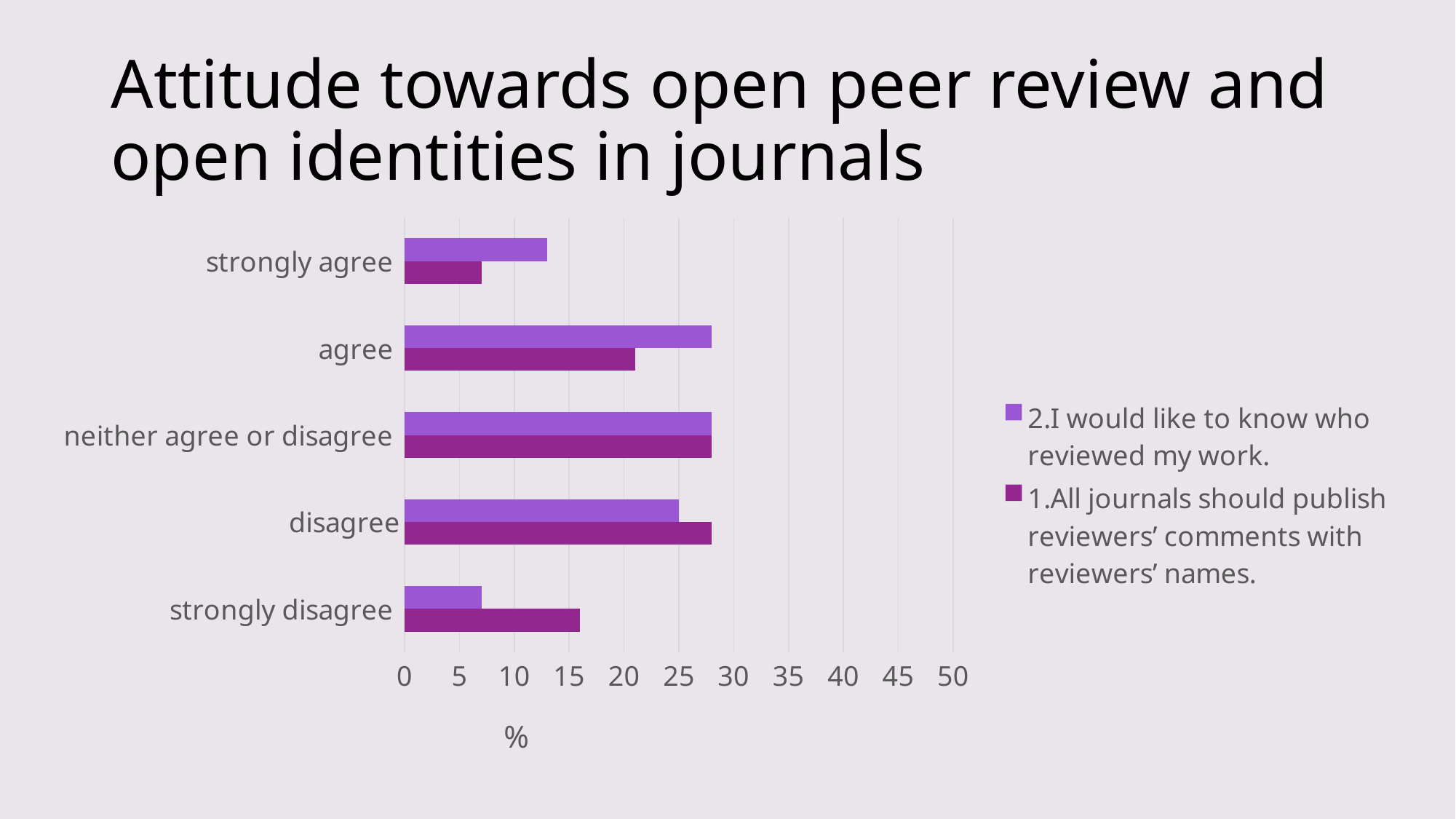
Is the value for 'agree' in the series '1.All journals should publish reviewers' comments with reviewers' names.' greater or less than 15? greater Is the value for 'strongly disagree' in the series '1.All journals should publish reviewers' comments with reviewers' names.' greater or less than 20? less For 'strongly agree', which series has the larger value? 2.I would like to know who reviewed my work. What is the label on the chart's x axis? % Which category has the lowest value for the series '1.All journals should publish reviewers' comments with reviewers' names.'? strongly agree For 'strongly disagree', which series has the larger value? 1.All journals should publish reviewers' comments with reviewers' names. Is the value for 'strongly agree' in the series '2.I would like to know who reviewed my work.' greater or less than 10? greater How many series does the chart's legend list? 2 How many response categories are shown on the y axis of the chart? 5 What kind of chart is shown on the slide? bar chart Which category has the lowest value for the series '2.I would like to know who reviewed my work.'? strongly disagree